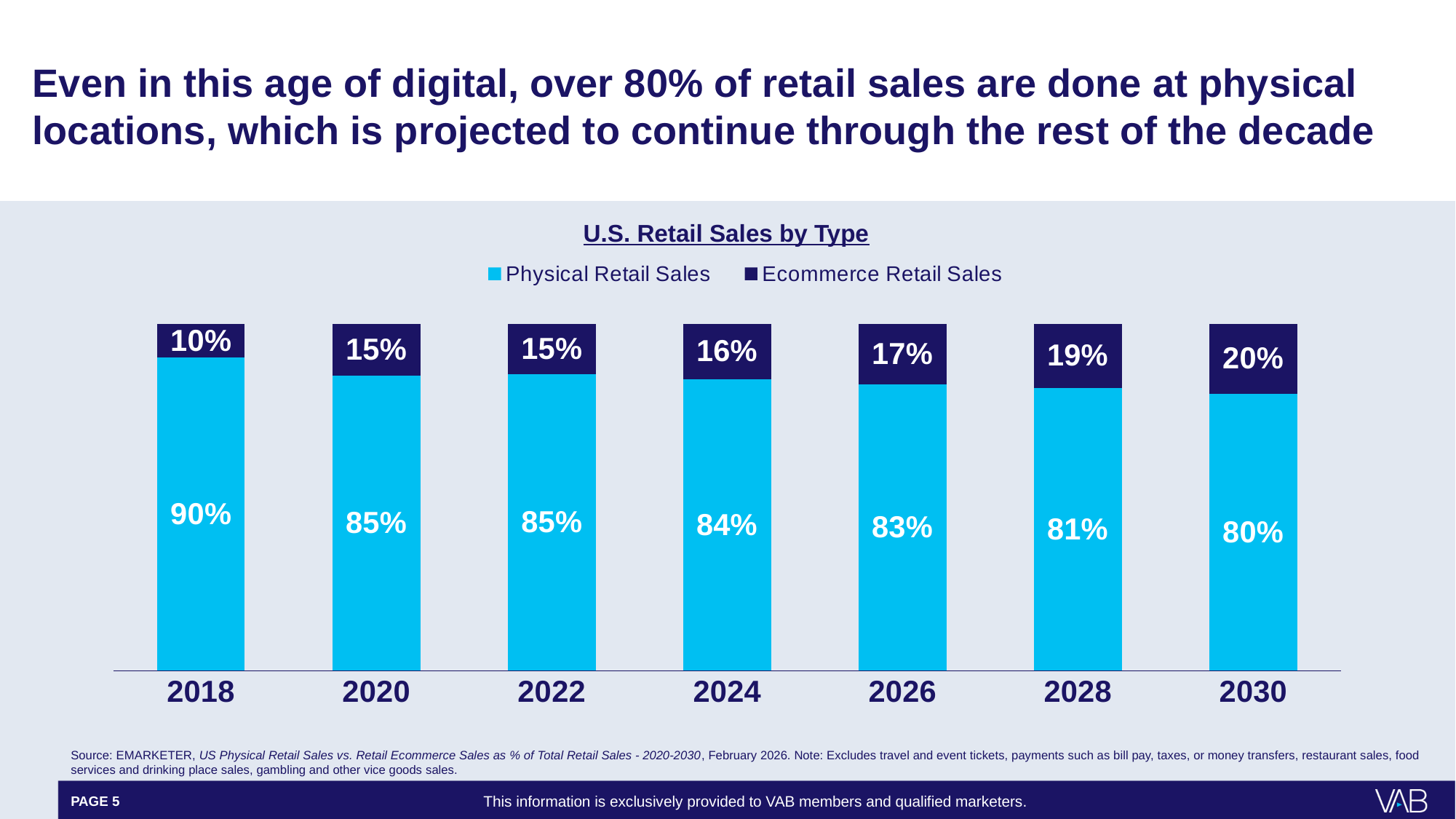
What is the difference between the Physical Retail Sales value in 2018 and in 2030? 10% What is the title of the chart? U.S. Retail Sales by Type Do the Ecommerce Retail Sales values rise or fall from 2018 to 2030? Rise Which is larger, the Ecommerce Retail Sales value for 2026 or for 2028? 2028 What is the Ecommerce Retail Sales value for 2030? 20% How many years are shown on the x axis? 7 What is the Ecommerce Retail Sales value for 2024? 16% Which year has the highest Physical Retail Sales share? 2018 Which year has the lowest Ecommerce Retail Sales share? 2018 How many series does the legend list? 2 What is the Physical Retail Sales value for 2018? 90% What kind of chart is shown? Stacked bar chart